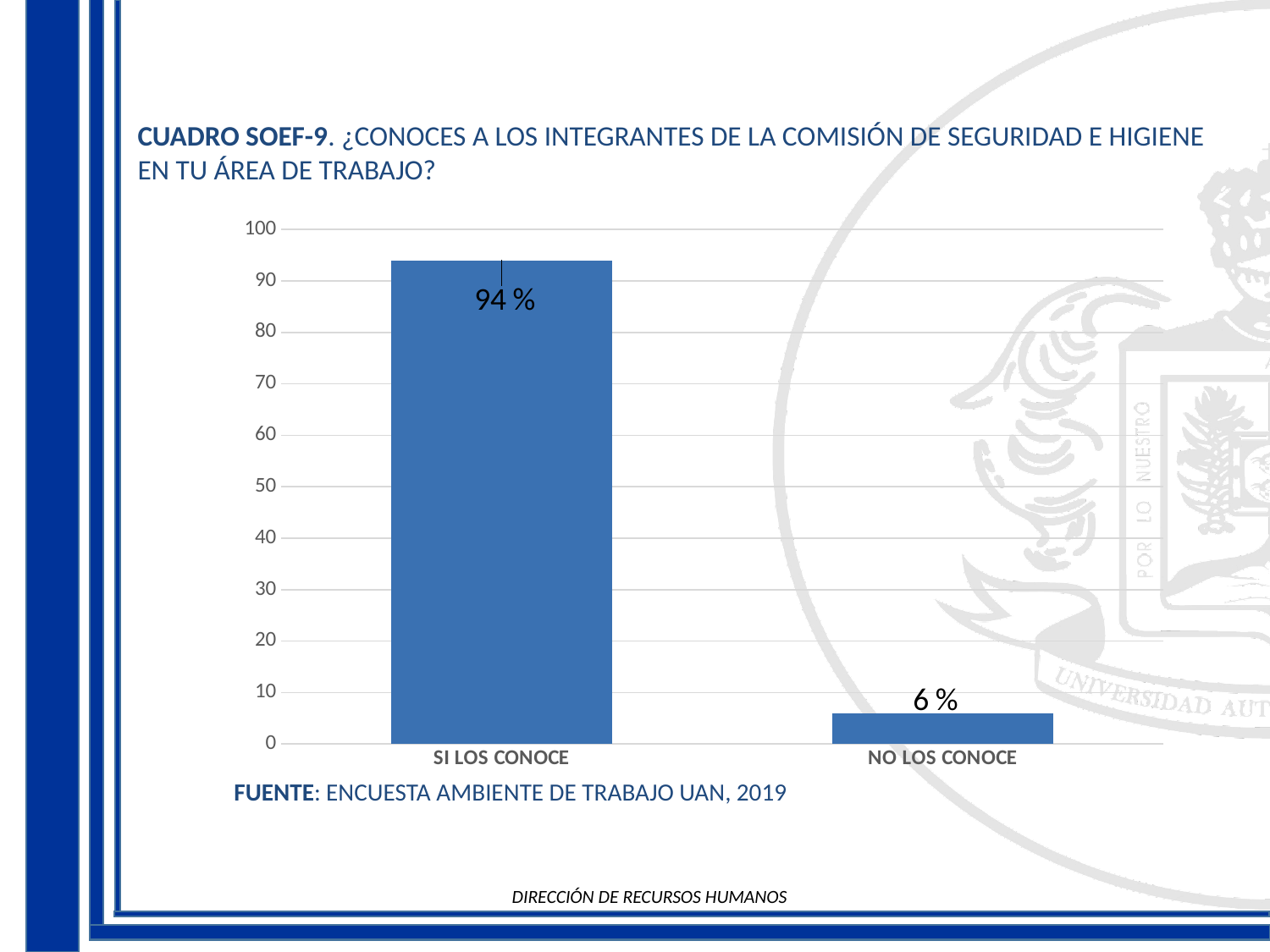
What kind of chart is shown on the slide? bar chart Is the value for NO LOS CONOCE greater or less than 10? less Is the value for SI LOS CONOCE greater or less than 90? greater What is the value for SI LOS CONOCE? 94 % Which category has the highest value? SI LOS CONOCE How many categories are shown on the x axis? 2 What is the value for NO LOS CONOCE? 6 % What is the maximum value shown on the vertical axis? 100 Which is larger, the value for SI LOS CONOCE or the value for NO LOS CONOCE? SI LOS CONOCE What is the source cited below the chart? ENCUESTA AMBIENTE DE TRABAJO UAN, 2019 Which category has the lowest value? NO LOS CONOCE What is the difference between the values for SI LOS CONOCE and NO LOS CONOCE? 88 %